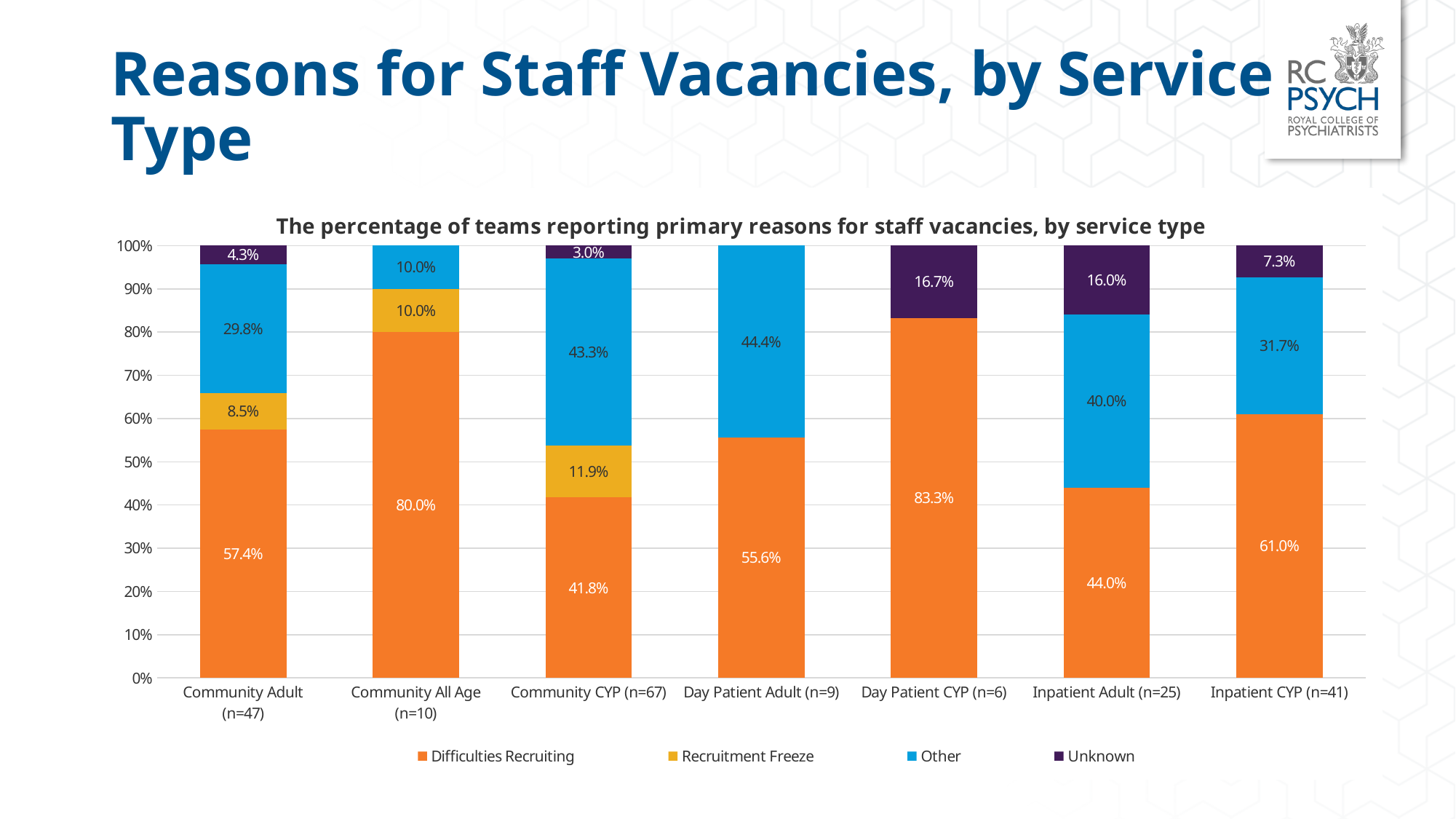
What is the difference between the Difficulties Recruiting values for Community All Age (n=10) and Community Adult (n=47)? 22.6% How many service types are shown on the x axis? 7 Which service type has the lowest percentage for Difficulties Recruiting? Community CYP (n=67) What kind of chart is shown on the slide? Stacked bar chart What percentage of Community Adult (n=47) teams reported Difficulties Recruiting as the primary reason for staff vacancies? 57.4% Which service type has the highest percentage for Difficulties Recruiting? Day Patient CYP (n=6) How many series does the legend list? 4 What percentage of Community CYP (n=67) teams reported a Recruitment Freeze? 11.9% Which is larger for Inpatient Adult (n=25): Difficulties Recruiting or Other? Difficulties Recruiting Which colour represents Recruitment Freeze in the chart? Yellow What is the value for Other in the Inpatient CYP (n=41) bar? 31.7% What is the Unknown value for Day Patient CYP (n=6)? 16.7%